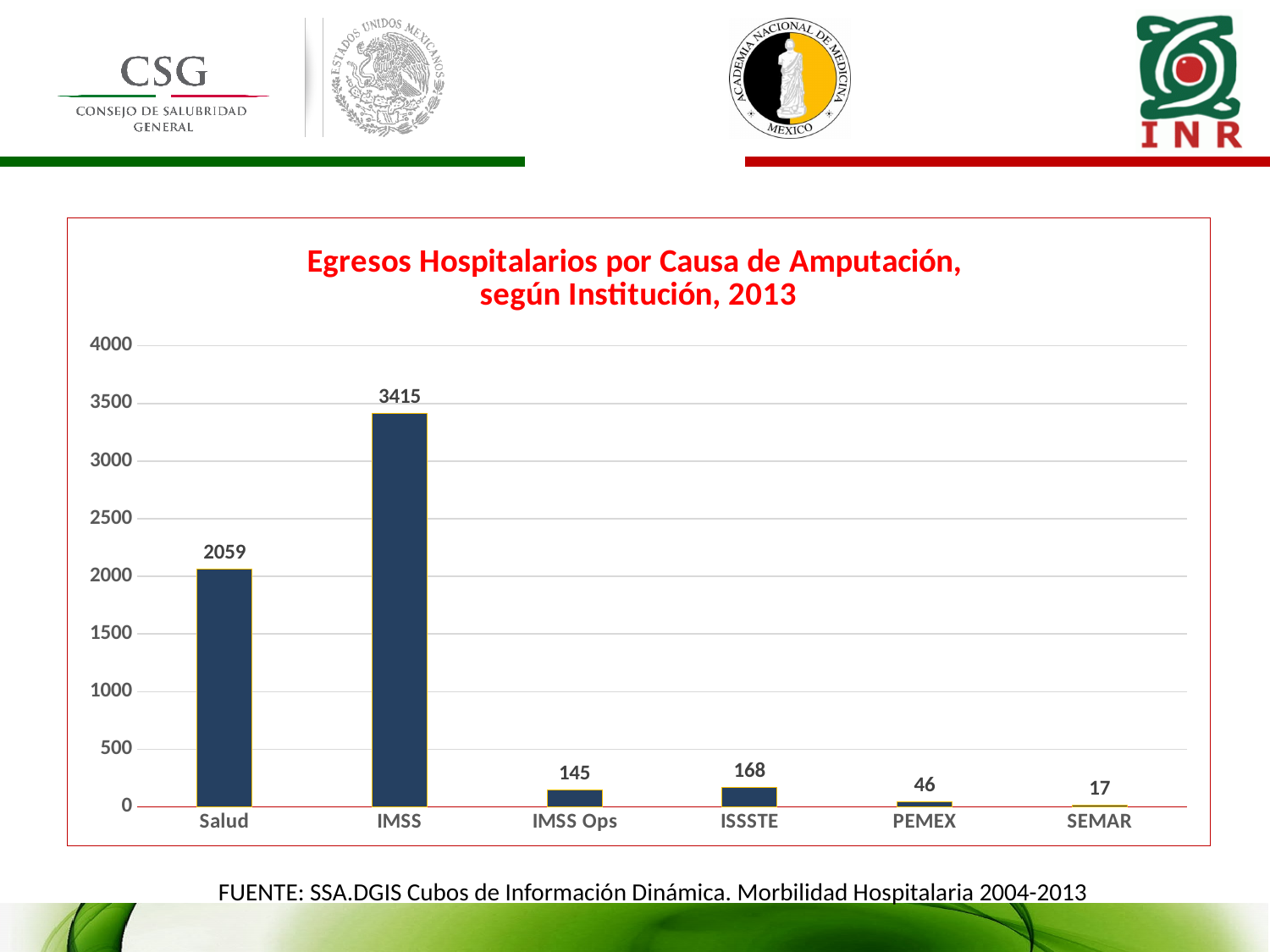
What is the title of the chart? Egresos Hospitalarios por Causa de Amputación, según Institución, 2013 What is the value for Salud? 2059 Which institution has the lowest value? SEMAR What is the value for IMSS? 3415 Which is larger, the value for ISSSTE or the value for IMSS Ops? ISSSTE Which institution has the highest value? IMSS What is the difference between the values for IMSS and Salud? 1356 What kind of chart is shown? Bar chart How many institutions are shown on the x axis? 6 What is the value for PEMEX? 46 What is the value for SEMAR? 17 What is the difference between the values for ISSSTE and IMSS Ops? 23